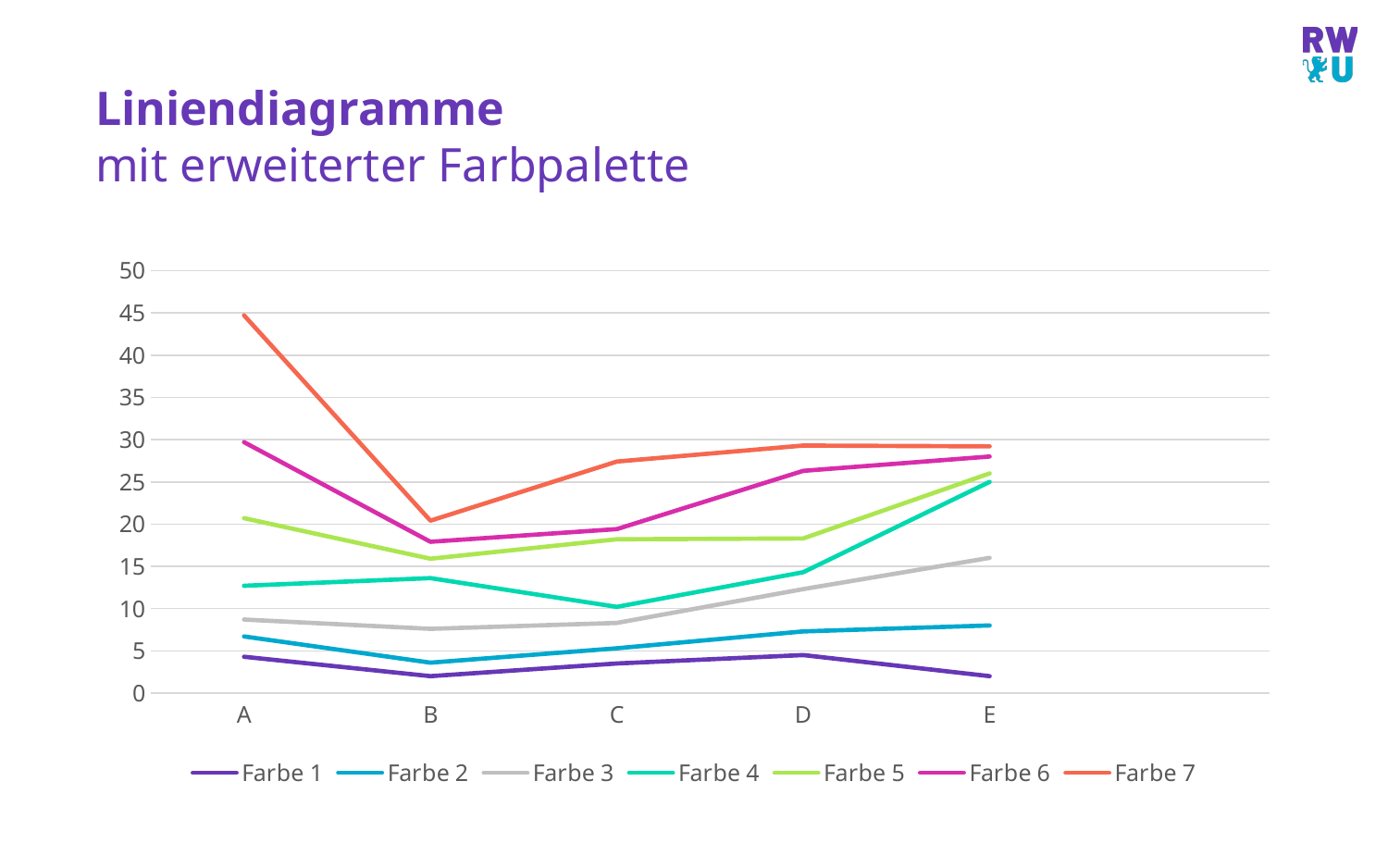
Is the value for Farbe 7 at category A greater or less than 40? greater What is the title of the slide containing the chart? Liniendiagramme mit erweiterter Farbpalette Is the value for Farbe 1 at category B greater or less than 5? less Which series has the highest value at category A? Farbe 7 What kind of chart is shown on the slide? line chart Is the value for Farbe 4 at category E greater or less than 20? greater Does the value for Farbe 3 rise or fall from category C to category E? rise How many categories are shown on the x axis? 5 At category A, which is larger: Farbe 6 or Farbe 5? Farbe 6 At which category does Farbe 7 have its lowest value? B At which category does Farbe 7 reach its highest value? A How many series does the legend list? 7